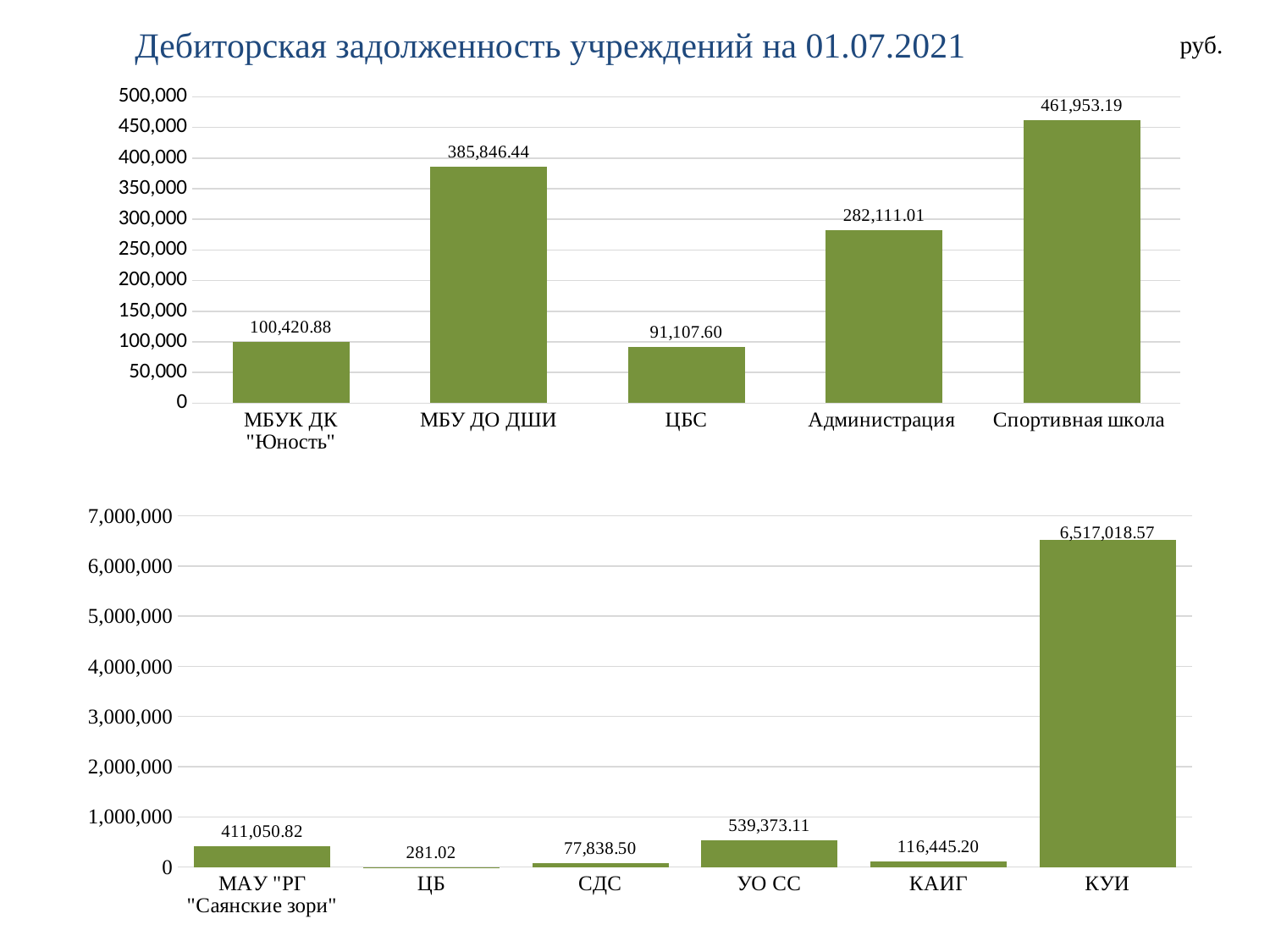
On the top chart, what is the difference between Спортивная школа and МБУ ДО ДШИ? 76,106.75 On the top chart, how many categories are shown? 5 On the bottom chart, which is larger, УО СС or МАУ "РГ "Саянские зори"? УО СС On the top chart, what is the value for Спортивная школа? 461,953.19 On the top chart, what is the value for ЦБС? 91,107.60 On the bottom chart, what is the difference between УО СС and МАУ "РГ "Саянские зори"? 128,322.29 On the top chart, which category has the highest value? Спортивная школа On the bottom chart, what is the value for КУИ? 6,517,018.57 On the bottom chart, which category has the highest value? КУИ On the bottom chart, what is the value for ЦБ? 281.02 On the top chart, which category has the lowest value? ЦБС What type of chart is the bottom chart? Bar chart